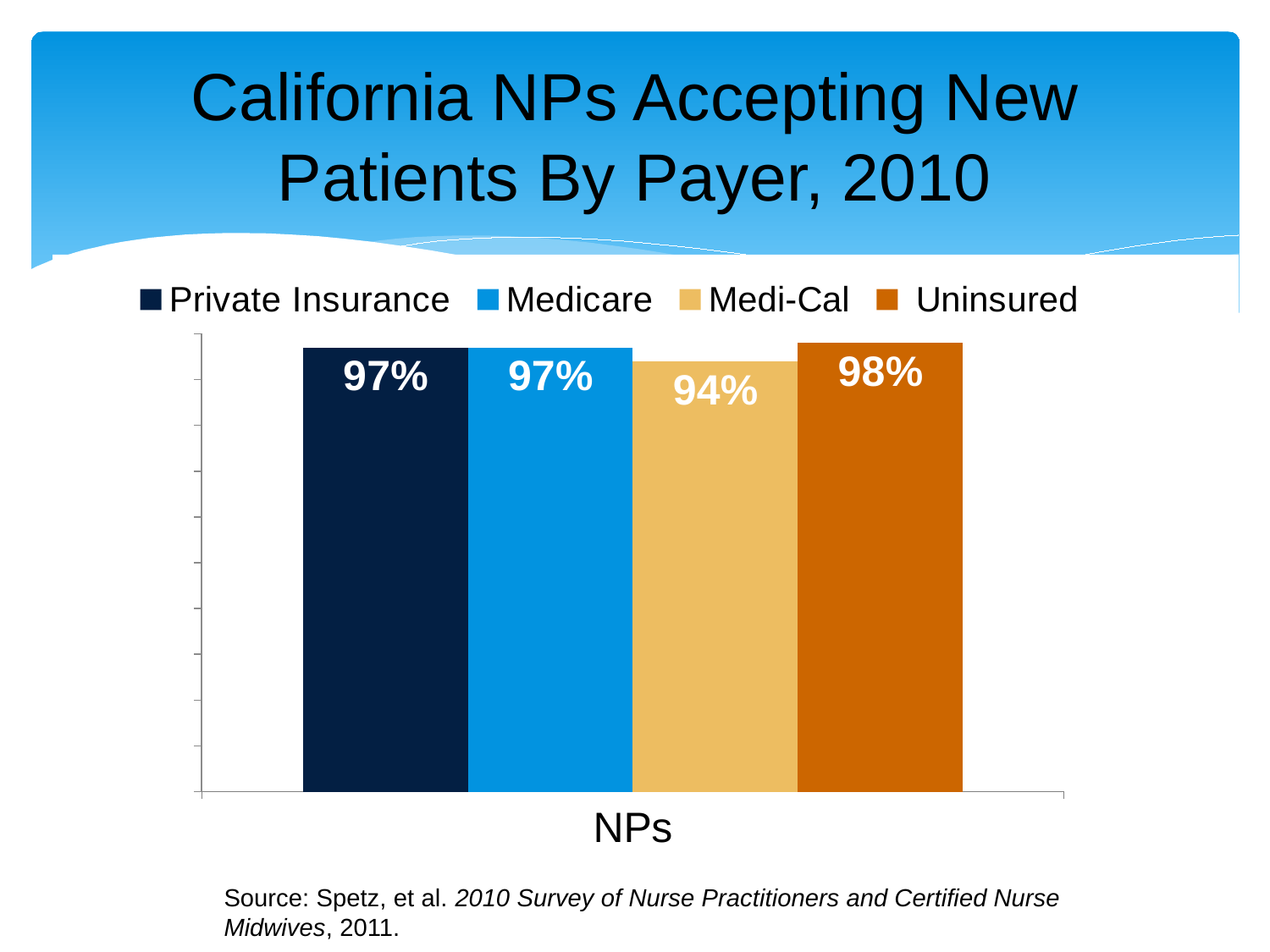
What percentage of California NPs accept new patients with Private Insurance? 97% Which is larger, the value for Medicare or the value for Medi-Cal? Medicare What percentage of California NPs accept new Medicare patients? 97% What is the difference in percentage points between Uninsured and Medi-Cal? 4 What percentage of California NPs accept new Uninsured patients? 98% What is the difference in percentage points between Private Insurance and Medi-Cal? 3 What percentage of California NPs accept new Medi-Cal patients? 94% What is the title of the chart on the slide? California NPs Accepting New Patients By Payer, 2010 Which payer has the lowest percentage of NPs accepting new patients? Medi-Cal How many series does the legend list? 4 What kind of chart is shown on the slide? Bar chart Which payer has the highest percentage of NPs accepting new patients? Uninsured